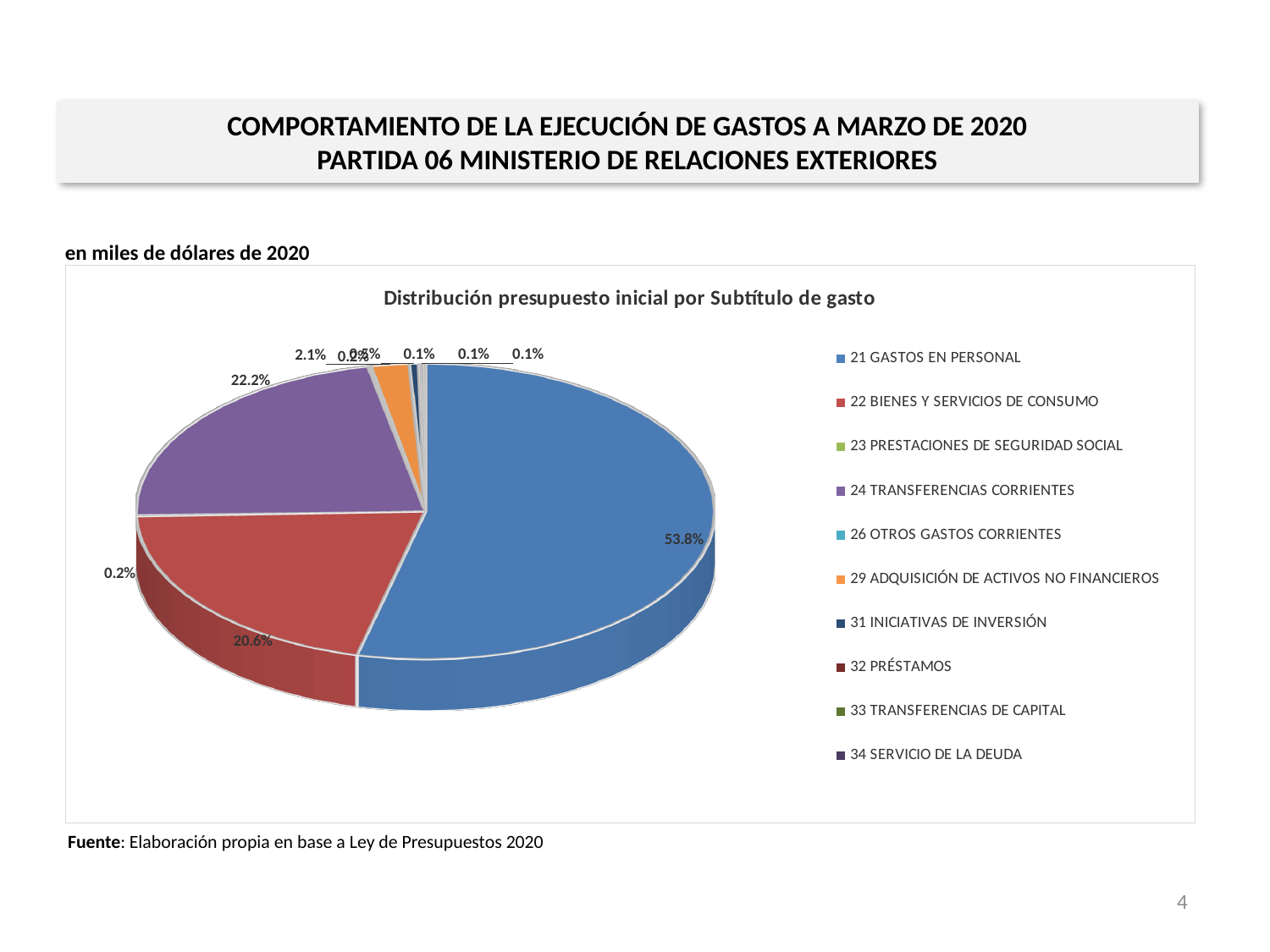
What share of the pie does 21 GASTOS EN PERSONAL represent? 53.8% Which slice is larger: 22 BIENES Y SERVICIOS DE CONSUMO or 24 TRANSFERENCIAS CORRIENTES? 24 TRANSFERENCIAS CORRIENTES What share of the pie does 22 BIENES Y SERVICIOS DE CONSUMO represent? 20.6% How many entries does the chart legend list? 10 What share of the pie does 24 TRANSFERENCIAS CORRIENTES represent? 22.2% What unit note is printed above the chart? en miles de dólares de 2020 What is the title of the chart? Distribución presupuesto inicial por Subtítulo de gasto Which category has the largest slice of the pie? 21 GASTOS EN PERSONAL What kind of chart is shown on the slide? Pie chart What is the difference in percentage points between the share of 21 GASTOS EN PERSONAL and 22 BIENES Y SERVICIOS DE CONSUMO? 33.2 percentage points Is the share for 21 GASTOS EN PERSONAL greater or less than 50%? greater